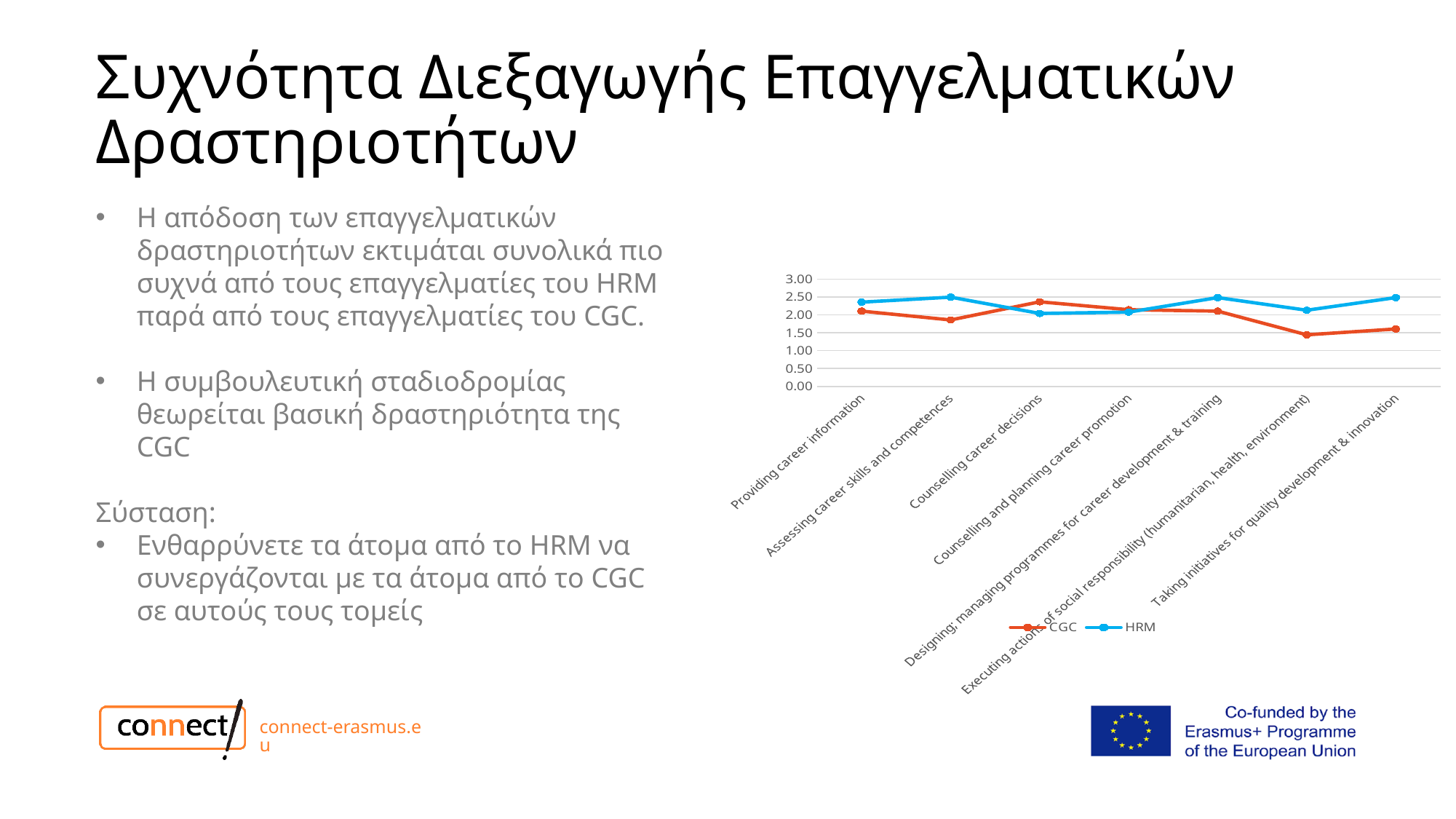
For 'Taking initiatives for quality development & innovation', which series has the higher value, CGC or HRM? HRM What kind of chart is shown on the slide? line chart For 'Counselling career decisions', which series has the higher value, CGC or HRM? CGC Which series is drawn in red in the chart? CGC Which series is drawn in blue in the chart? HRM Is the CGC value for 'Assessing career skills and competences' greater or less than 2.00? less For 'Providing career information', which series has the higher value, CGC or HRM? HRM For which category is the CGC value highest? Counselling career decisions For which category is the CGC value lowest? Executing actions of social responsibility (humanitarian, health, environment) How many categories are plotted along the x axis of the chart? 7 How many series does the chart's legend list? 2 Is the HRM value for 'Taking initiatives for quality development & innovation' greater or less than 2.00? greater